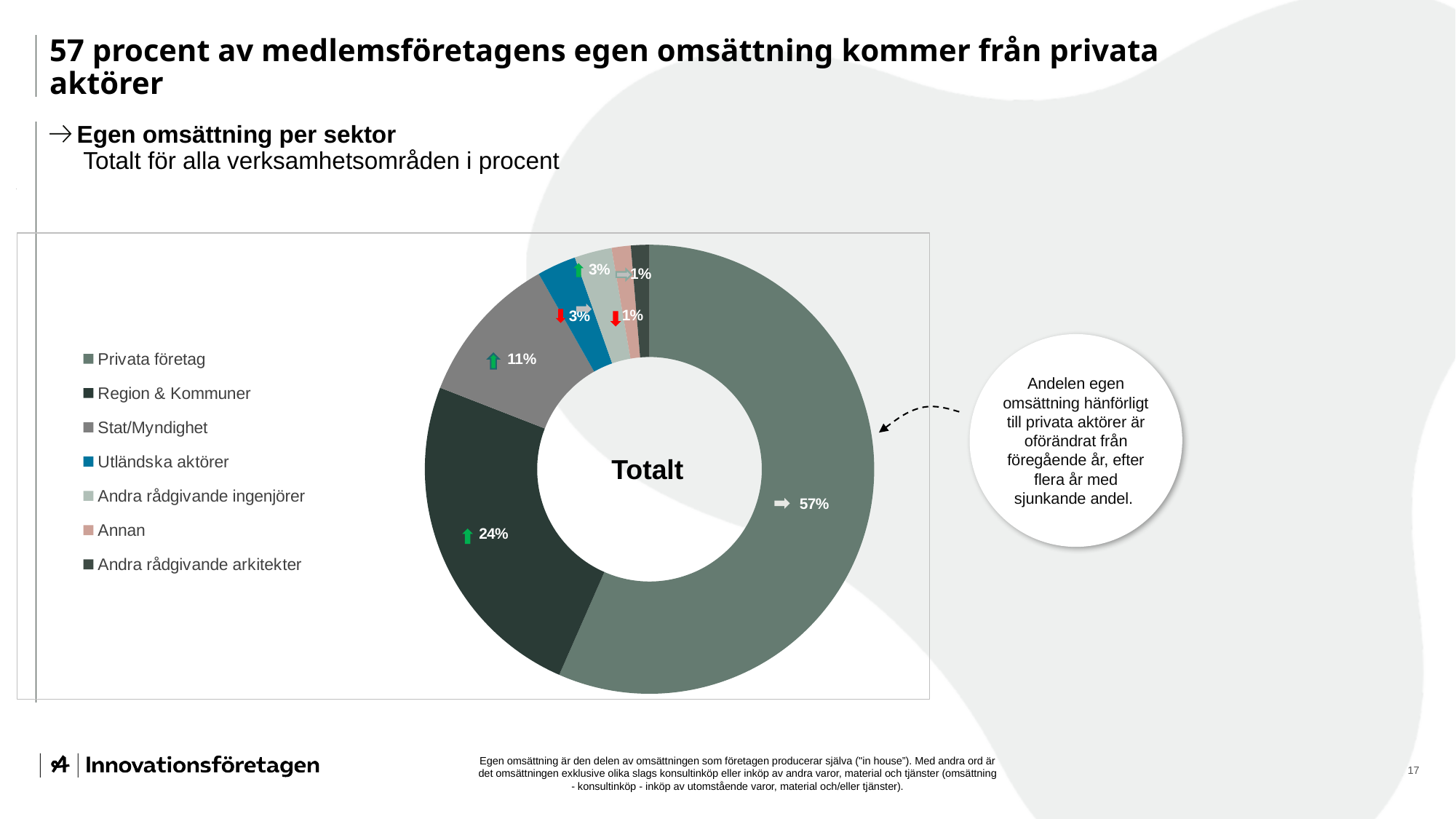
What kind of chart is shown on the slide? Pie (donut) chart What is the difference in percentage points between Region & Kommuner and Stat/Myndighet? 13 percentage points What is the value for Stat/Myndighet? 11% What is the value for Region & Kommuner? 24% Which is larger, the share for Region & Kommuner or the share for Stat/Myndighet? Region & Kommuner What is the value for Utländska aktörer? 3% Which sector has the largest share of the pie? Privata företag What text is shown in the centre of the donut chart? Totalt How many sectors are listed in the legend? 7 What is the difference in percentage points between Privata företag and Region & Kommuner? 33 percentage points What share of egen omsättning comes from Privata företag? 57% What is the title of the chart? Egen omsättning per sektor